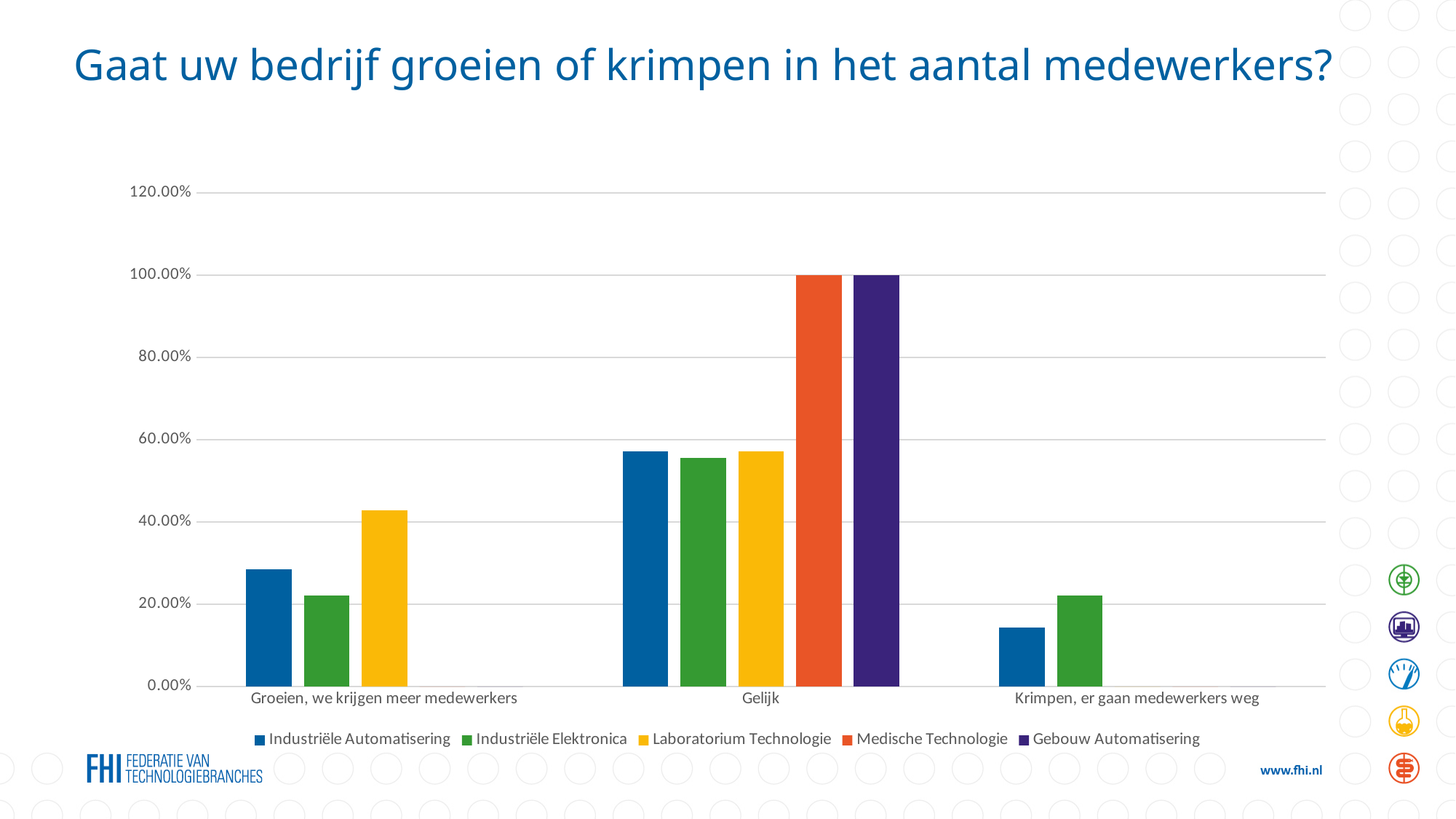
How many series does the legend list? 5 How many categories are shown on the x axis? 3 What is the value for Gebouw Automatisering in the 'Gelijk' category? 100.00% In the 'Krimpen, er gaan medewerkers weg' category, which is larger: Industriële Automatisering or Industriële Elektronica? Industriële Elektronica What is the title of the slide? Gaat uw bedrijf groeien of krimpen in het aantal medewerkers? Is the value for Industriële Automatisering in the 'Krimpen, er gaan medewerkers weg' category greater or less than 20.00%? less What kind of chart is shown on the slide? bar chart In the 'Groeien, we krijgen meer medewerkers' category, which is larger: Industriële Automatisering or Laboratorium Technologie? Laboratorium Technologie What is the value for Medische Technologie in the 'Gelijk' category? 100.00% Which series has the highest value in the 'Groeien, we krijgen meer medewerkers' category? Laboratorium Technologie Is the value for Laboratorium Technologie in the 'Groeien, we krijgen meer medewerkers' category greater or less than 40.00%? greater